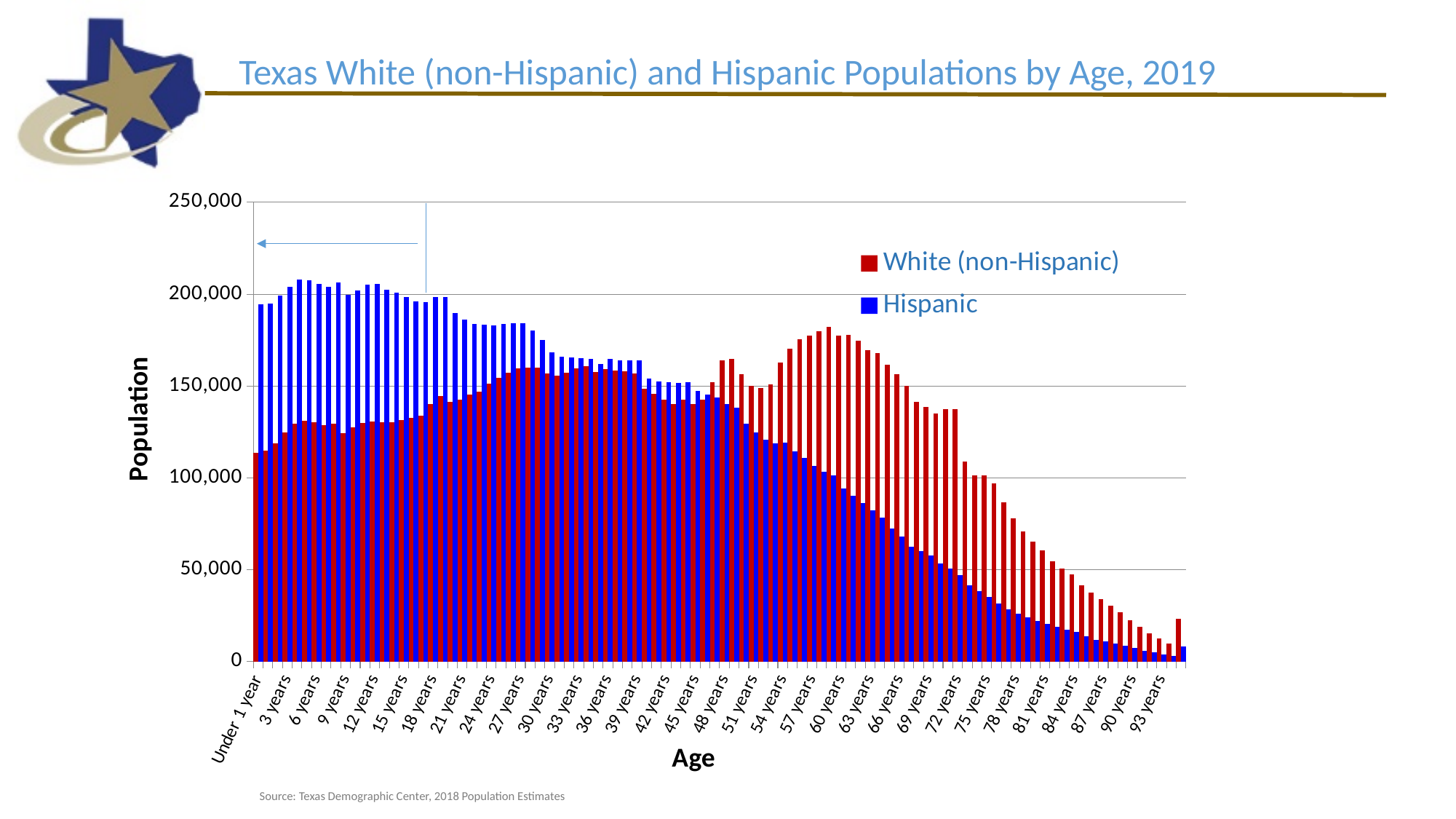
Is the White (non-Hispanic) value for 93 years greater or less than 50,000? less How many series does the legend list? 2 At 60 years, which series has the larger value, White (non-Hispanic) or Hispanic? White (non-Hispanic) What kind of chart is shown on the slide? bar chart Is the White (non-Hispanic) value for 60 years greater or less than 150,000? greater Is the Hispanic value for Under 1 year greater or less than 150,000? greater What colour represents the Hispanic series in the legend? blue Do the Hispanic values generally rise or fall from 30 years to 93 years? fall At Under 1 year, which series has the larger value, White (non-Hispanic) or Hispanic? Hispanic